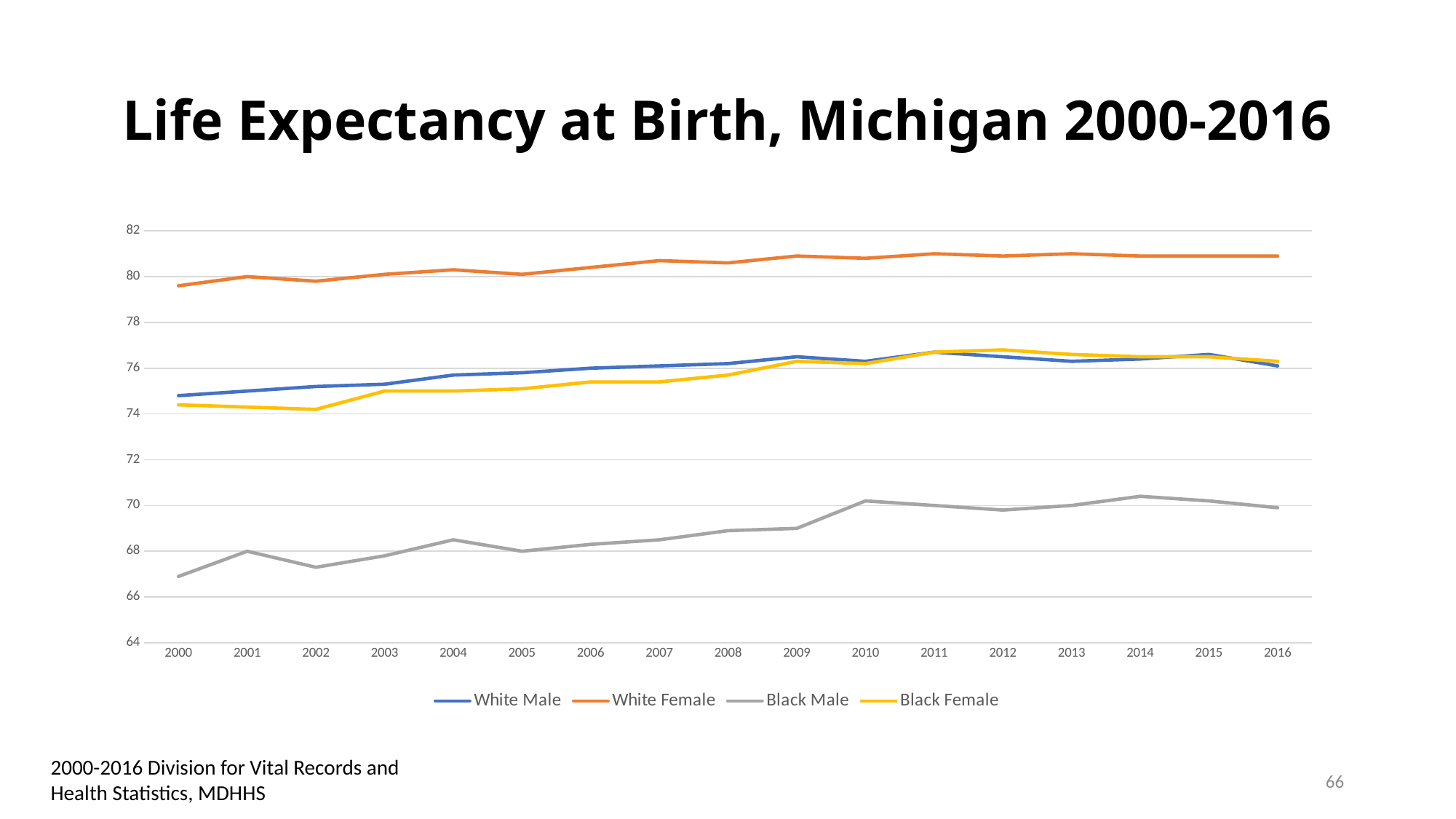
How many years are plotted along the x axis? 17 Which series has the highest life expectancy across all years? White Female Which series has the lowest life expectancy across all years? Black Male How many series does the legend list? 4 Does the Black Male line generally rise or fall from 2000 to 2016? rise Is the value for White Male in 2000 greater or less than 76? less What colour is the Black Female line in the legend? yellow What kind of chart is shown on the slide? line chart Is the value for White Female in 2016 greater or less than 80? greater Is the value for Black Female in 2002 greater or less than 76? less In 2002, which is larger: the value for White Male or the value for Black Female? White Male